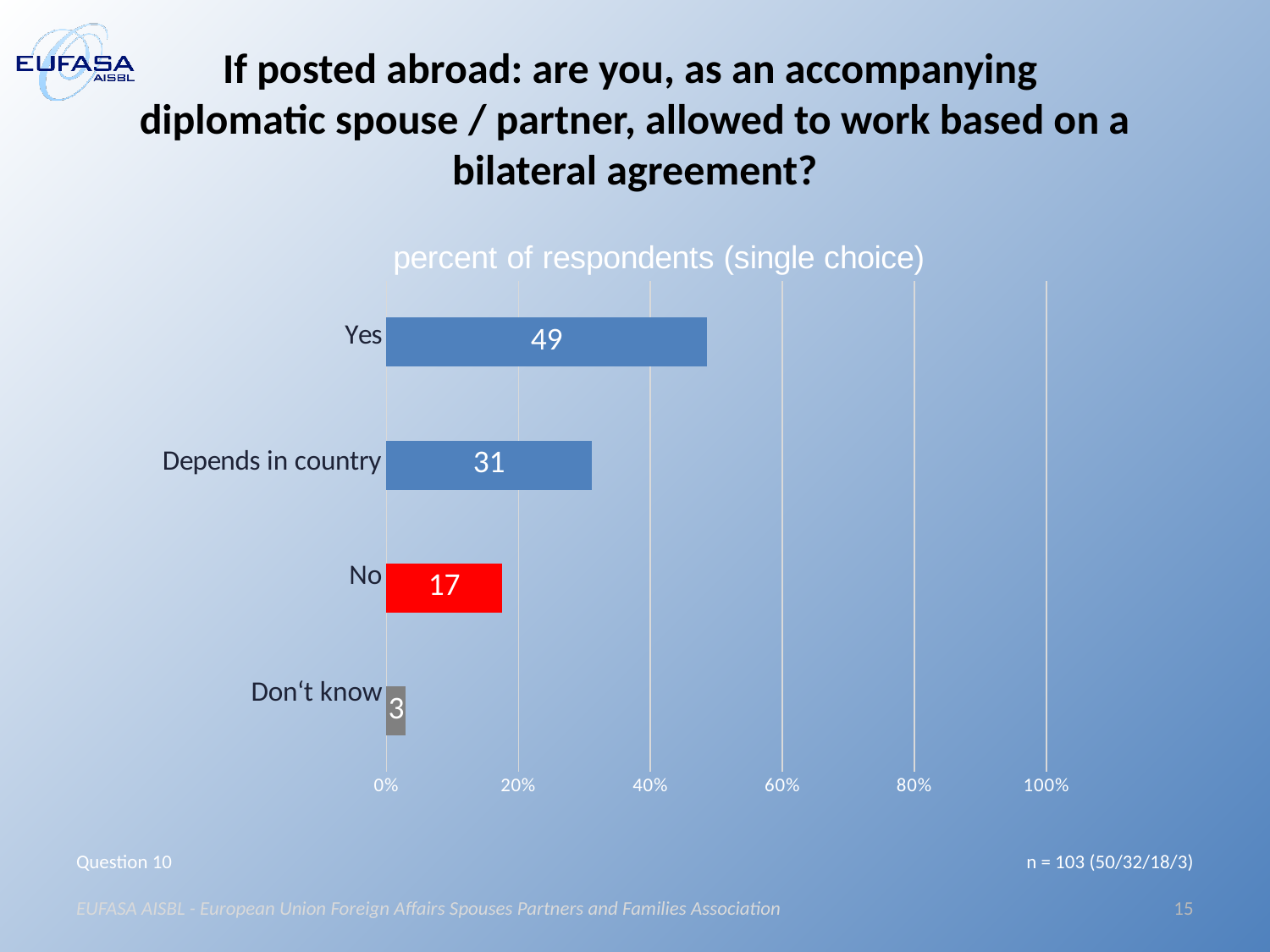
What kind of chart is shown on the slide? bar chart What is the value for Yes? 49 How many categories are shown in the chart? 4 What is the difference between the values for Yes and No? 32 Which category has the lowest value? Don't know What is the value for Don't know? 3 What is the value for No? 17 Which is larger, the value for Depends in country or the value for No? Depends in country Which category has the highest value? Yes Is the value for Yes greater or less than 40%? greater What is the title of the chart? percent of respondents (single choice) What is the value for Depends in country? 31